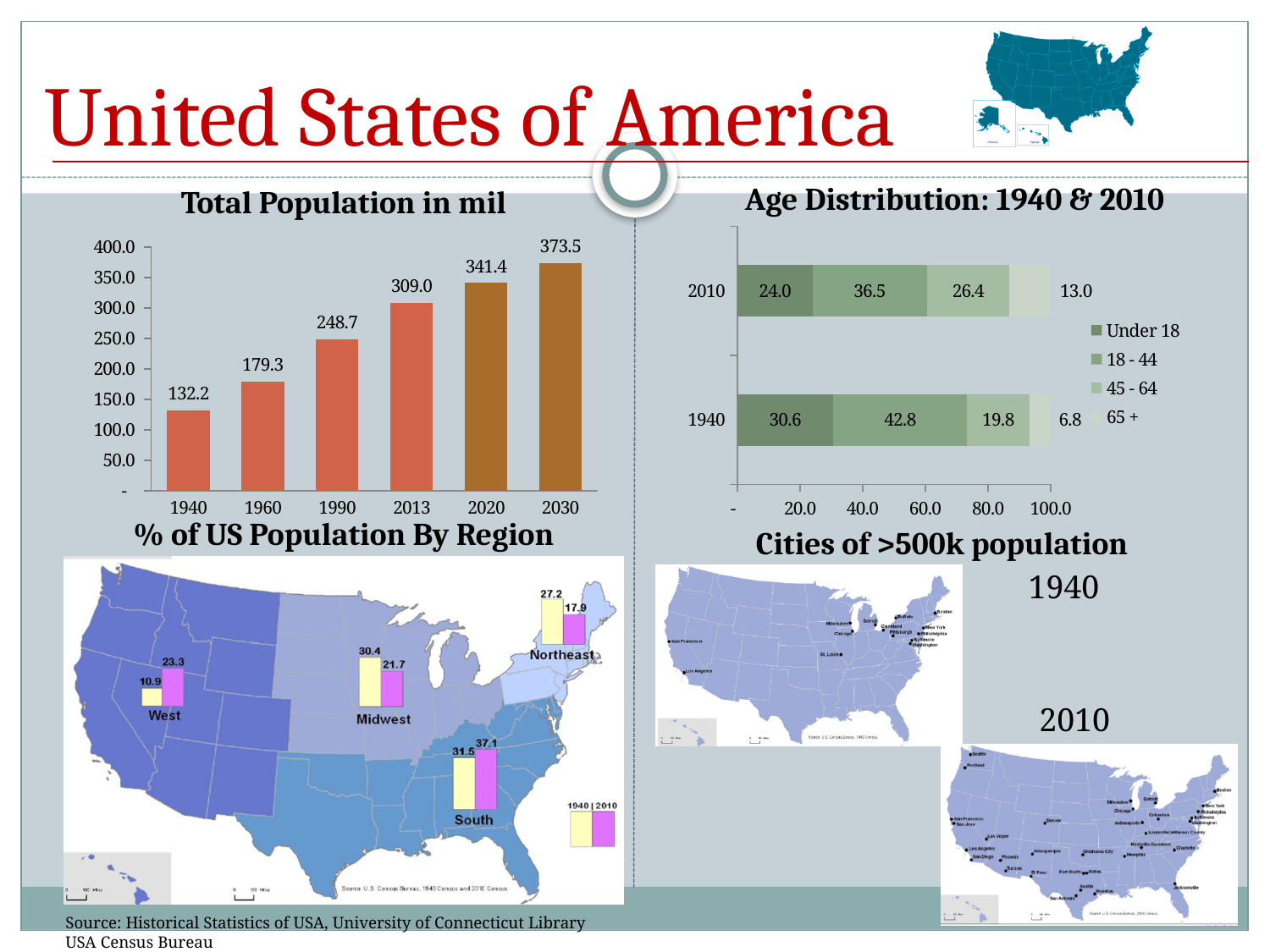
In the Total Population in mil chart, do the values rise or fall from 1940 to 2030? rise What kind of chart is the Total Population in mil chart? bar chart In the Total Population in mil chart, what is the difference between the values for 2013 and 1940? 176.8 In the Age Distribution: 1940 & 2010 chart, what is the value for the 65 + group in 2010? 13.0 In the Age Distribution: 1940 & 2010 chart, which is larger: the Under 18 value for 1940 or for 2010? 1940 In the Age Distribution: 1940 & 2010 chart, what is the value for the 18 - 44 group in 1940? 42.8 In the % of US Population By Region map, what is the difference between the 2010 and 1940 values for the West? 12.4 In the Total Population in mil chart, what is the value for 1990? 248.7 In the Total Population in mil chart, which year has the highest value? 2030 In the % of US Population By Region map, what is the 2010 value for the South? 37.1 In the Total Population in mil chart, how many years are shown on the x axis? 6 In the Age Distribution: 1940 & 2010 chart, how many series does the legend list? 4